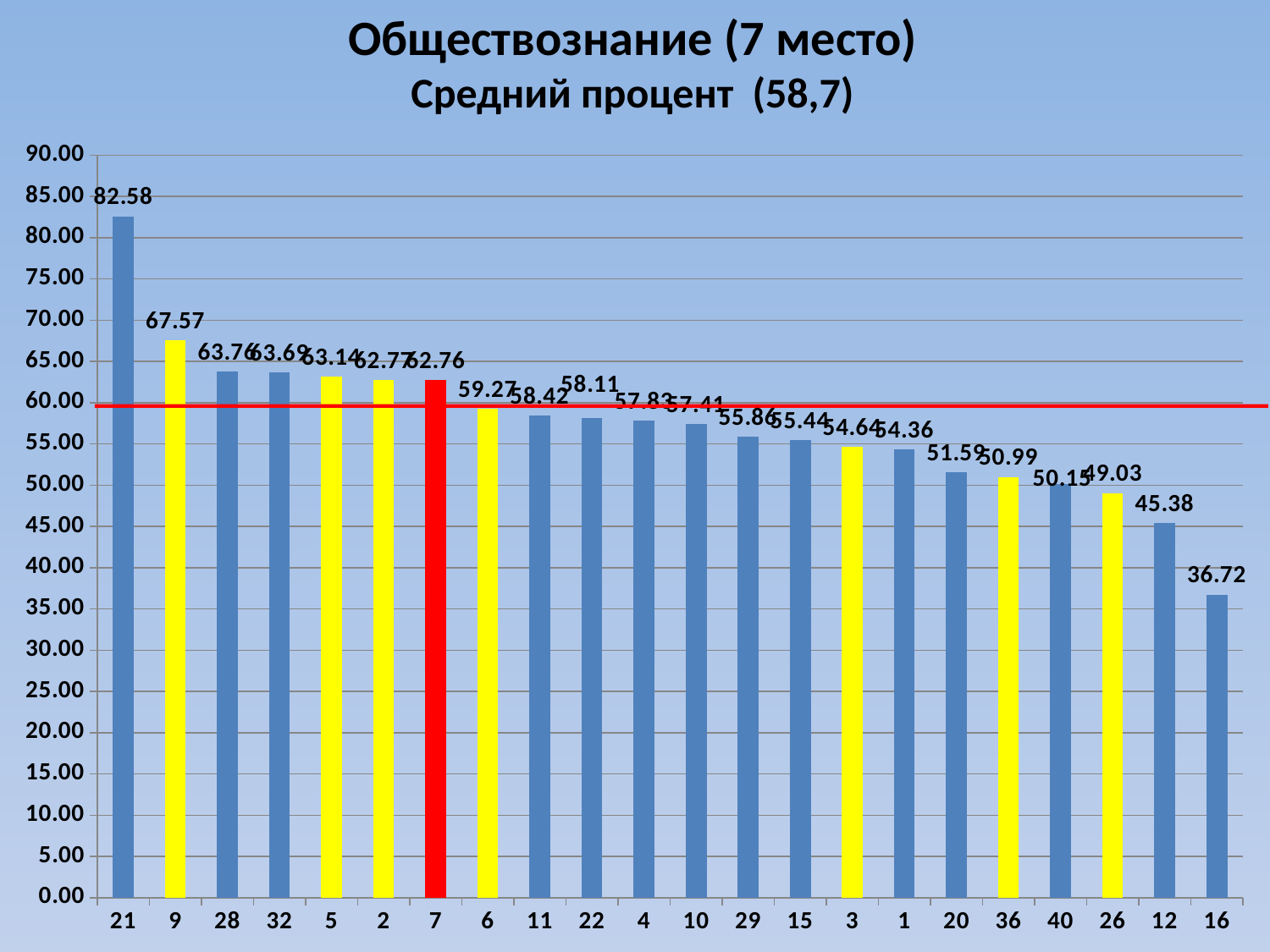
Which is larger, the value for category 9 or the value for category 12? 9 What is the value for category 16? 36.72 What is the difference between the values for category 21 and category 16? 45.86 What is the value for category 7, shown by the red bar? 62.76 What is the value for category 21? 82.58 Is the value for category 16 greater or less than 40.00? less What is the value for category 9? 67.57 Do the values rise or fall from left to right along the x axis? fall Which category has the lowest value? 16 How many bars are shown in the chart? 22 Which category has the highest value? 21 What is the value for category 12? 45.38